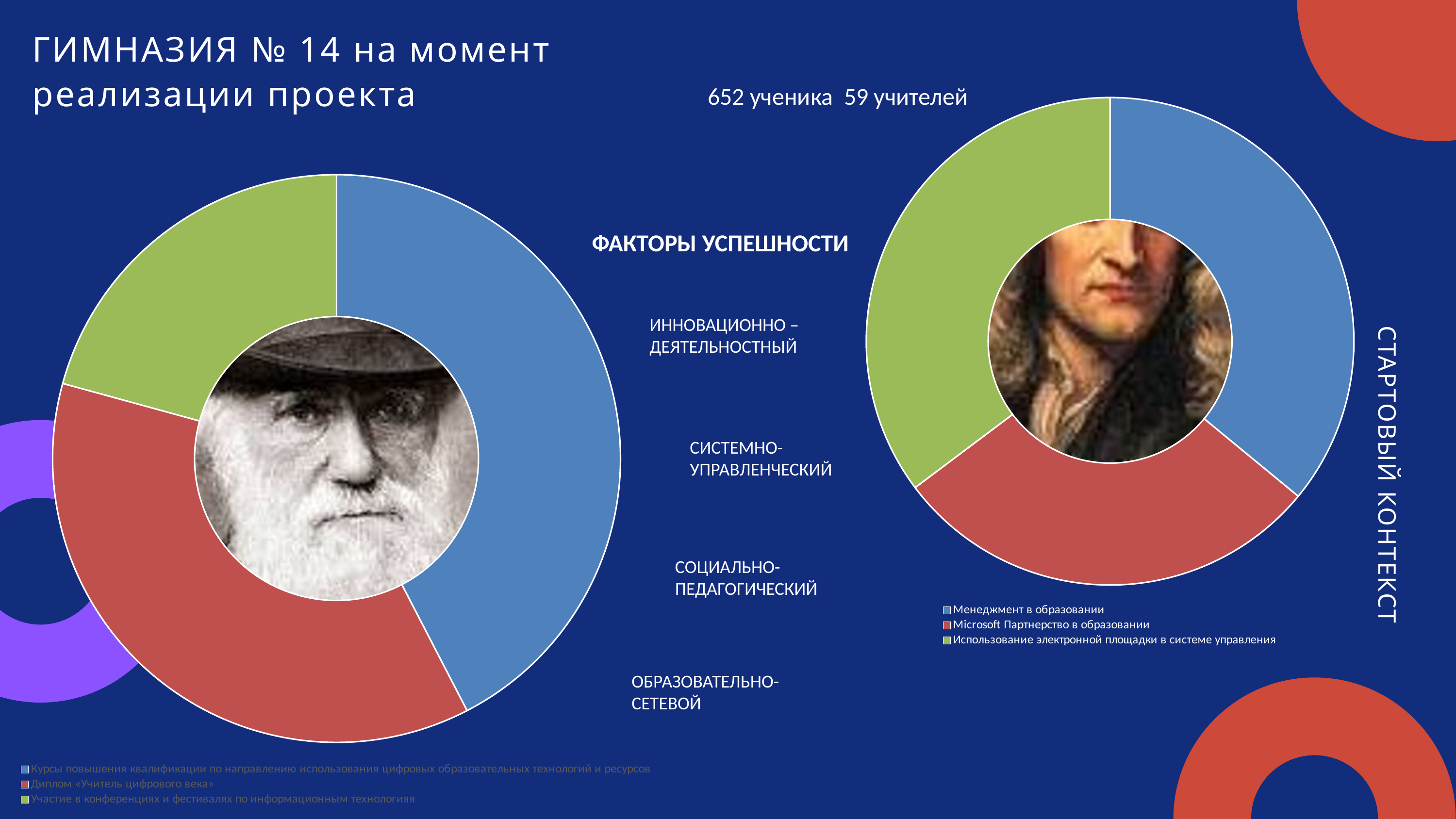
In the chart on the left side of the slide, how many slices does the doughnut have? 3 In the chart on the left side of the slide, which category has the smallest slice? Участие в конференциях и фестивалях по информационным технологияя What kind of chart is the chart on the right side of the slide? Doughnut chart In the chart on the right side of the slide, which legend entry is shown in red? Microsoft Партнерство в образовании In the chart on the left side of the slide, which category has the largest slice? Курсы повышения квалификации по направлению использования цифровых образовательных технологий и ресурсов What kind of chart is the chart on the left side of the slide? Doughnut chart In the chart on the left side of the slide, which slice is larger: «Курсы повышения квалификации по направлению использования цифровых образовательных технологий и ресурсов» or «Диплом «Учитель цифрового века»»? Курсы повышения квалификации по направлению использования цифровых образовательных технологий и ресурсов In the chart on the left side of the slide, which slice is larger: «Диплом «Учитель цифрового века»» or «Участие в конференциях и фестивалях по информационным технологияя»? Диплом «Учитель цифрового века» In the chart on the right side of the slide, how many entries does the legend list? 3 In the chart on the right side of the slide, which legend entry is shown in green? Использование электронной площадки в системе управления